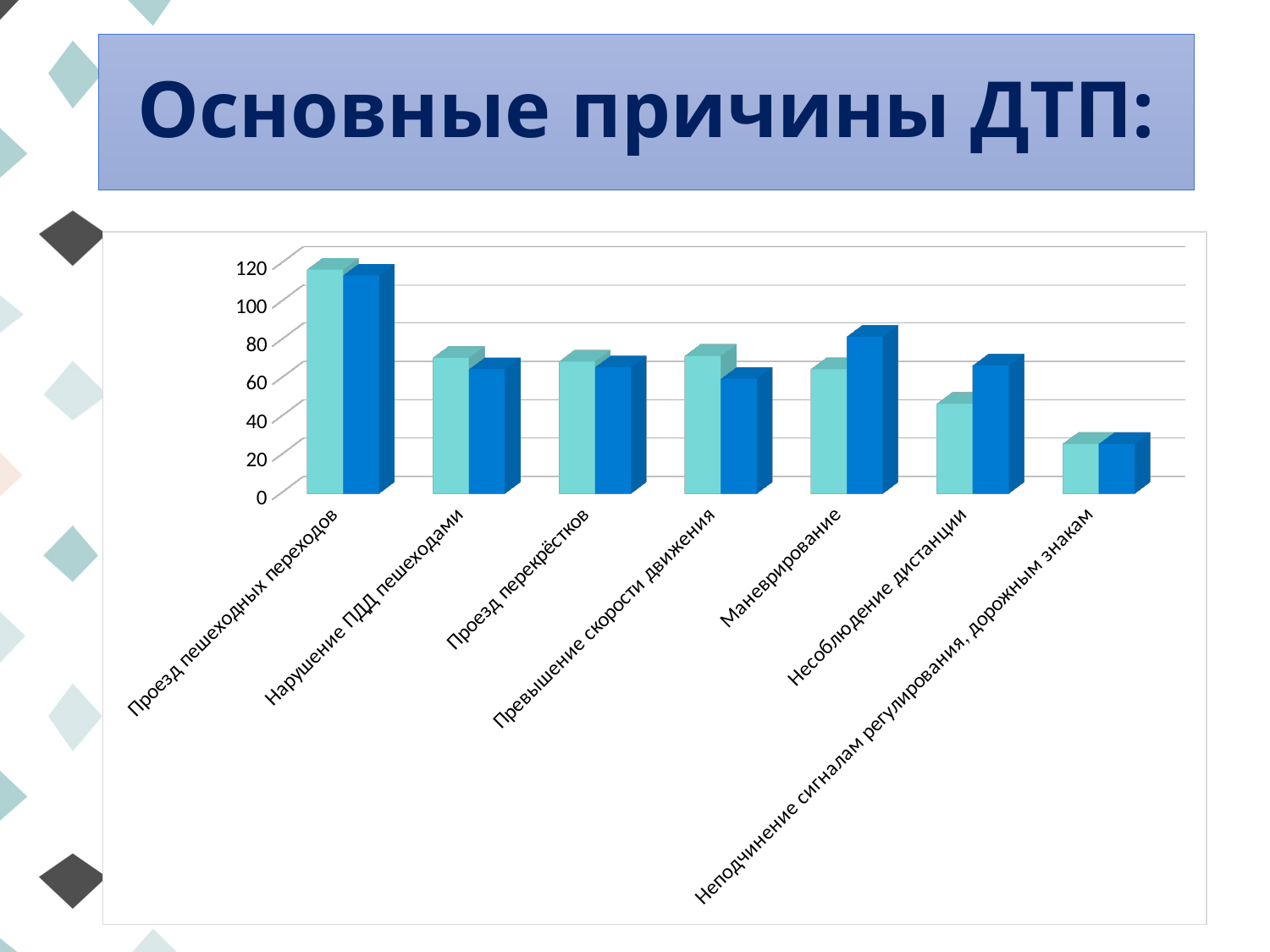
Is the dark-blue bar for Маневрирование greater or less than 60? greater What kind of chart is shown on the slide? Bar chart What is the title of the slide containing the chart? Основные причины ДТП: Which is larger: the light-blue bar for Проезд пешеходных переходов or the light-blue bar for Маневрирование? Проезд пешеходных переходов For Маневрирование, which bar is taller: the light-blue bar or the dark-blue bar? the dark-blue bar Is the light-blue bar for Несоблюдение дистанции greater or less than 60? less Is the light-blue bar for Неподчинение сигналам регулирования, дорожным знакам greater or less than 40? less How many bars are plotted for each category in the chart? 2 Which category has the lowest dark-blue bar in the chart? Неподчинение сигналам регулирования, дорожным знакам How many categories are shown on the x axis of the chart? 7 Which category has the highest light-blue bar in the chart? Проезд пешеходных переходов